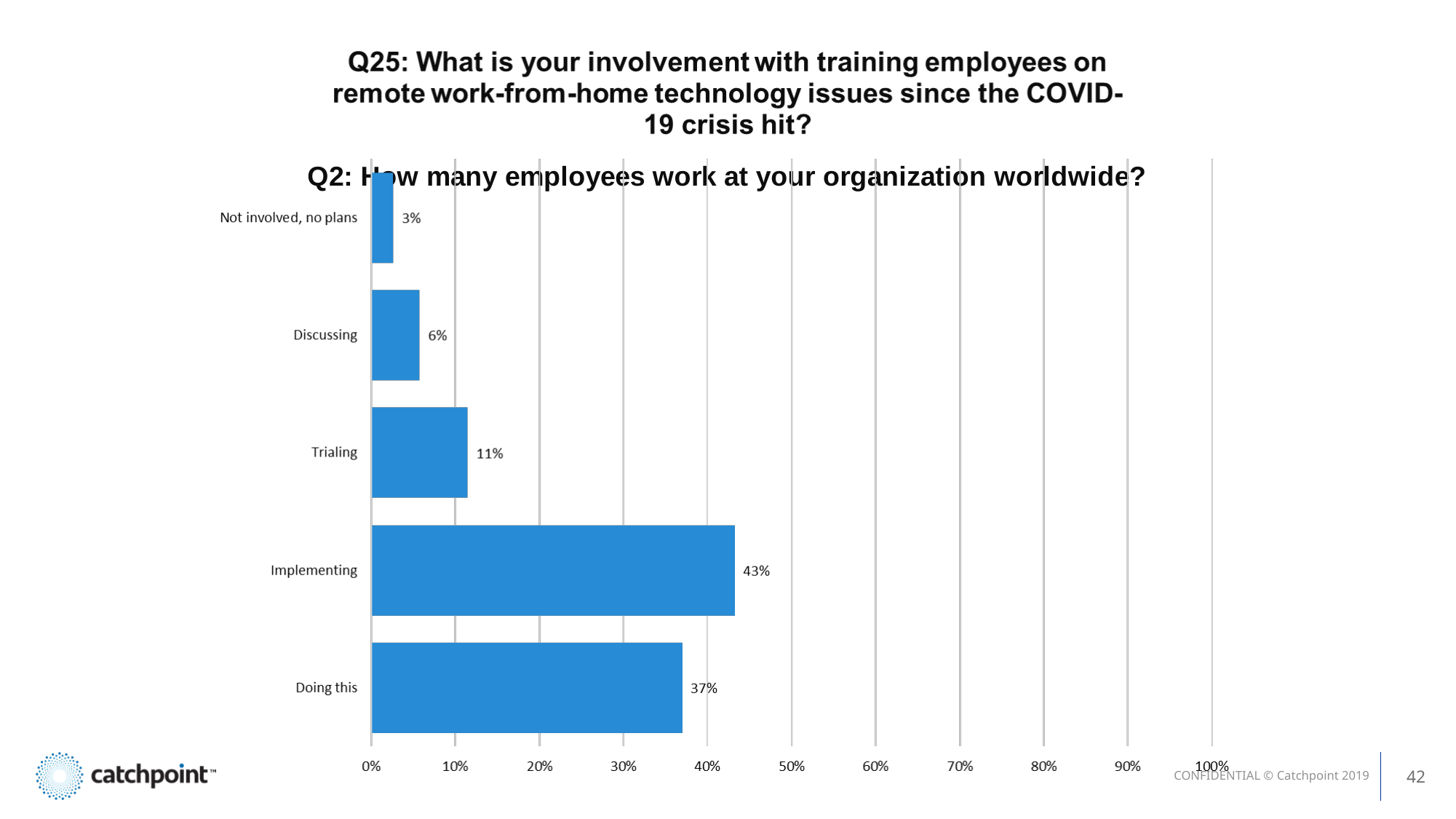
What kind of chart is shown on the slide? Bar chart Which category has the highest value? Implementing Which is larger, 'Discussing' or 'Trialing'? Trialing What percentage of respondents are 'Trialing'? 11% What is the difference between 'Discussing' and 'Not involved, no plans'? 3% What percentage of respondents are 'Implementing'? 43% Which category has the lowest value? Not involved, no plans Is the value for 'Implementing' greater or less than 40%? greater What is the value for 'Doing this'? 37% What is the difference between 'Implementing' and 'Doing this'? 6% How many categories are shown in the chart? 5 What is the value for 'Not involved, no plans'? 3%